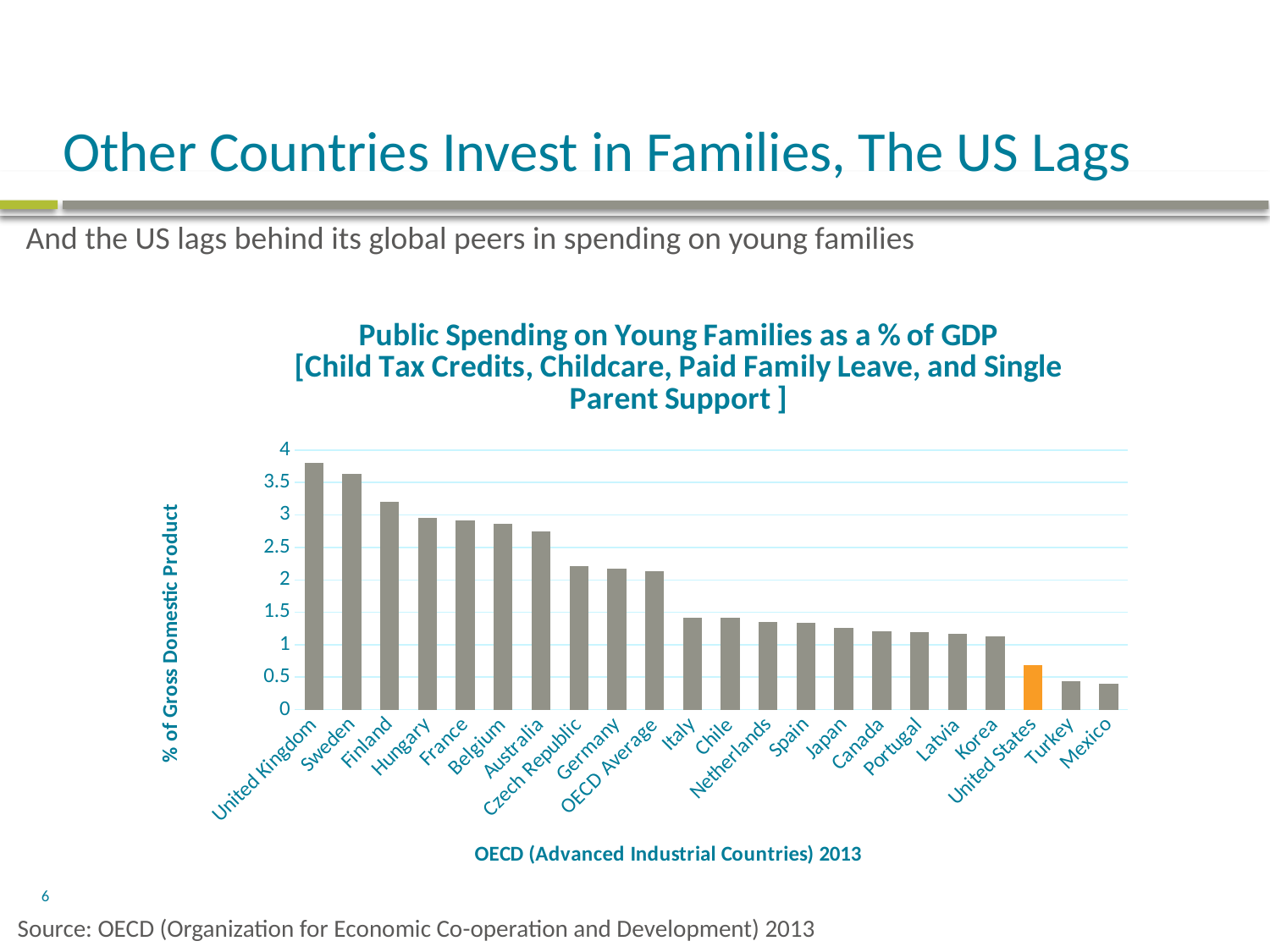
Which has a larger value, Korea or the United States? Korea What kind of chart is shown on the slide? Bar chart Is the value for the United States greater or less than 1? less Is the value for Germany greater or less than 2? greater Which country has the highest public spending on young families as a % of GDP? United Kingdom Is the value for Italy greater or less than 1.5? less Which has a larger value, Germany or Italy? Germany Which country's bar is highlighted in orange? United States How many countries or categories are plotted along the x axis? 22 Do the values rise or fall moving from left to right along the x axis? Fall